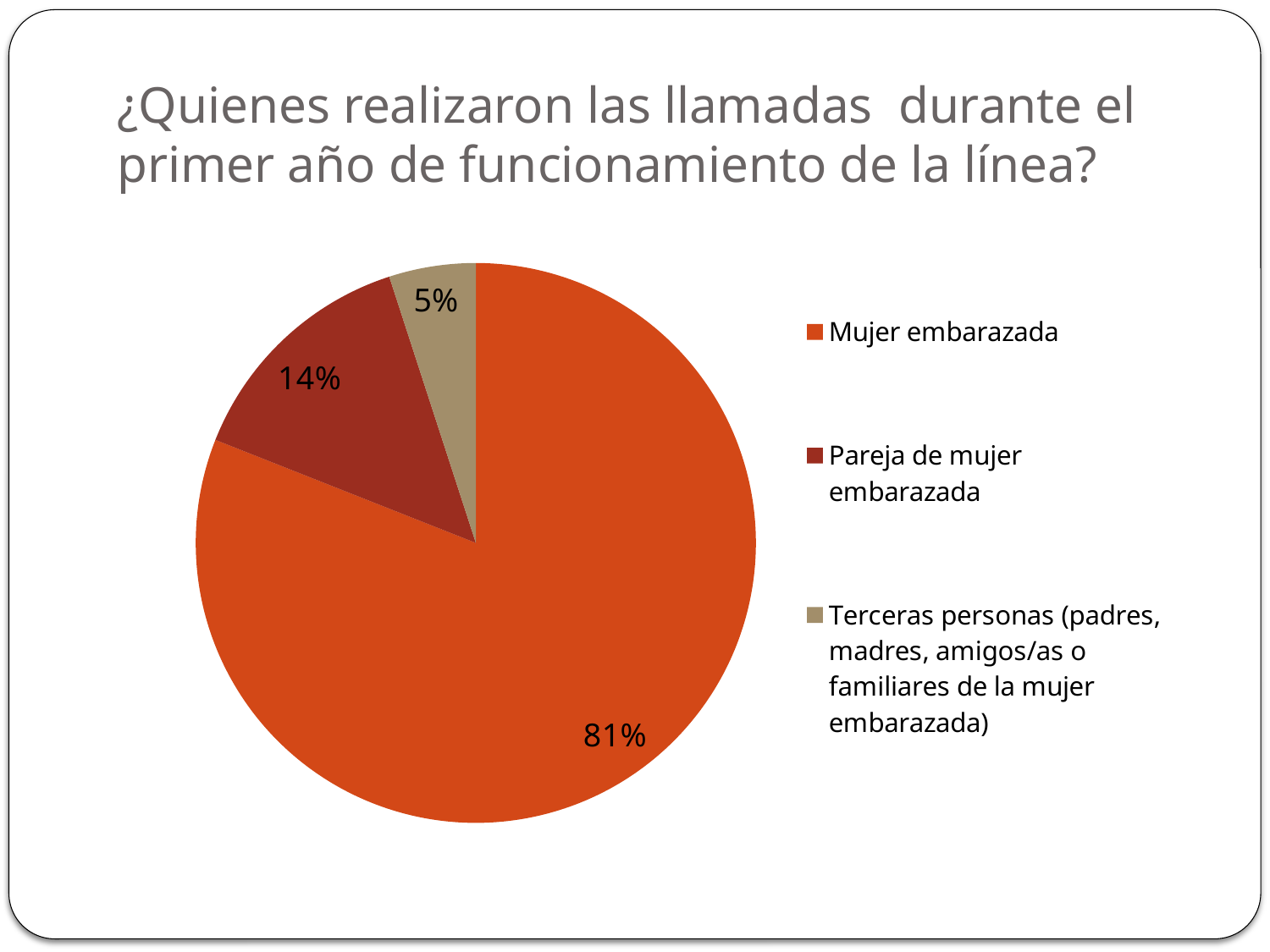
What kind of chart is shown on the slide? Pie chart What share of the calls were made by 'Mujer embarazada'? 81% What is the difference in percentage points between 'Pareja de mujer embarazada' and 'Terceras personas'? 9 Which category has the largest slice of the pie? Mujer embarazada Which is larger: the slice for 'Pareja de mujer embarazada' or the slice for 'Terceras personas'? Pareja de mujer embarazada What share of the calls were made by 'Terceras personas (padres, madres, amigos/as o familiares de la mujer embarazada)'? 5% Which category has the smallest slice of the pie? Terceras personas (padres, madres, amigos/as o familiares de la mujer embarazada) What is the title of the slide? ¿Quienes realizaron las llamadas durante el primer año de funcionamiento de la línea? What share of the calls were made by 'Pareja de mujer embarazada'? 14% How many slices does the pie chart have? 3 How many entries does the legend list? 3 What is the difference in percentage points between 'Mujer embarazada' and 'Pareja de mujer embarazada'? 67